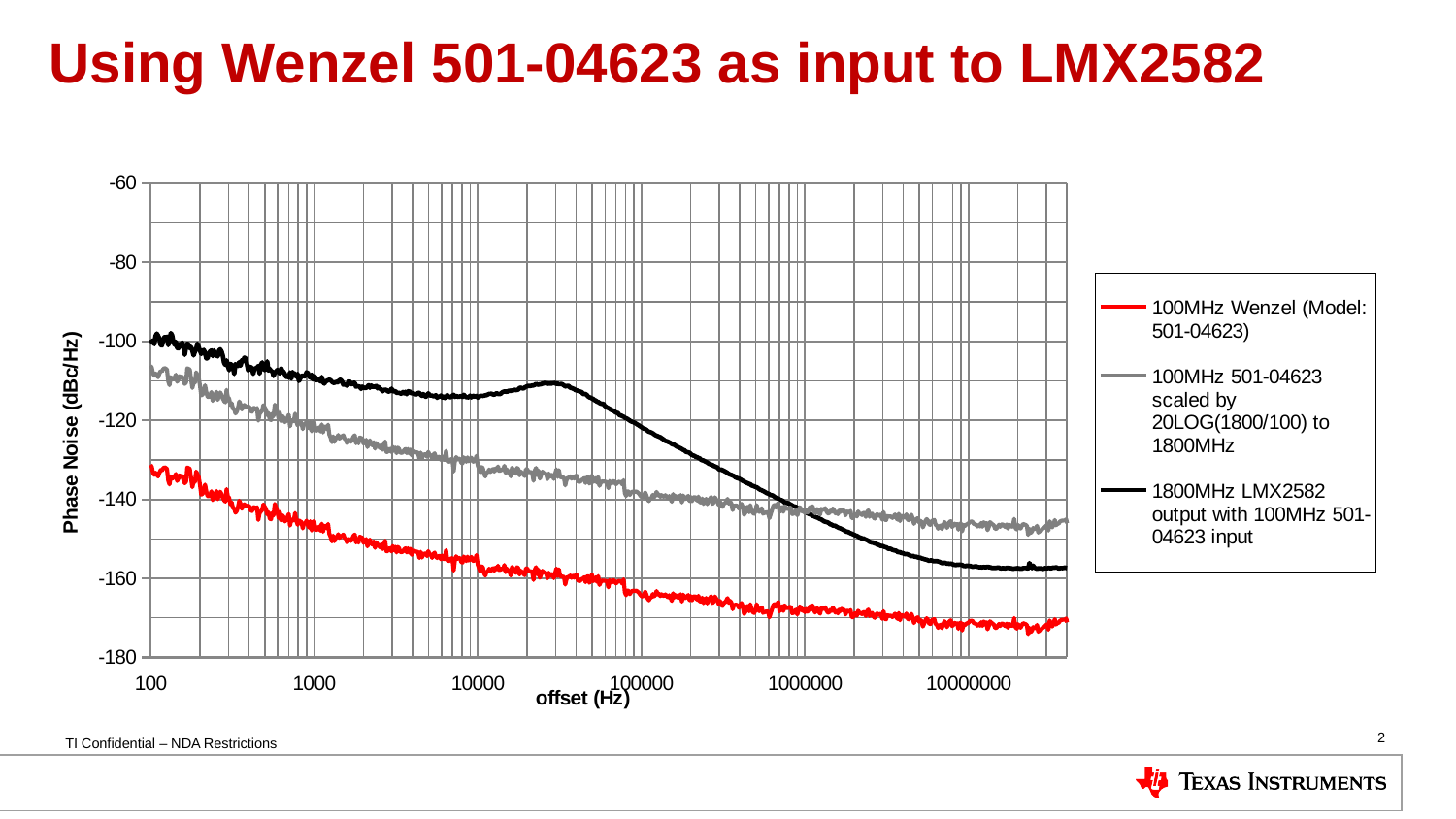
What is the label of the y axis? Phase Noise (dBc/Hz) How many series does the legend list? 3 Which series is drawn in red? 100MHz Wenzel (Model: 501-04623) Is the value of the 1800MHz LMX2582 output series at 100 Hz offset greater or less than -120? greater Does the 100MHz 501-04623 scaled by 20LOG(1800/100) to 1800MHz series rise or fall as the offset increases? fall Does the 100MHz Wenzel (Model: 501-04623) series rise or fall as the offset increases? fall Is the value of the 100MHz Wenzel (Model: 501-04623) series at 100 Hz offset greater or less than -120? less Is the value of the 1800MHz LMX2582 output series at 10000000 Hz offset greater or less than -140? less At 100 Hz offset, which series has the higher phase noise value: the 1800MHz LMX2582 output or the 100MHz Wenzel (Model: 501-04623)? 1800MHz LMX2582 output At 10000000 Hz offset, which series has the higher phase noise value: the 100MHz 501-04623 scaled to 1800MHz or the 1800MHz LMX2582 output? 100MHz 501-04623 scaled to 1800MHz What kind of chart is shown on the slide? line chart